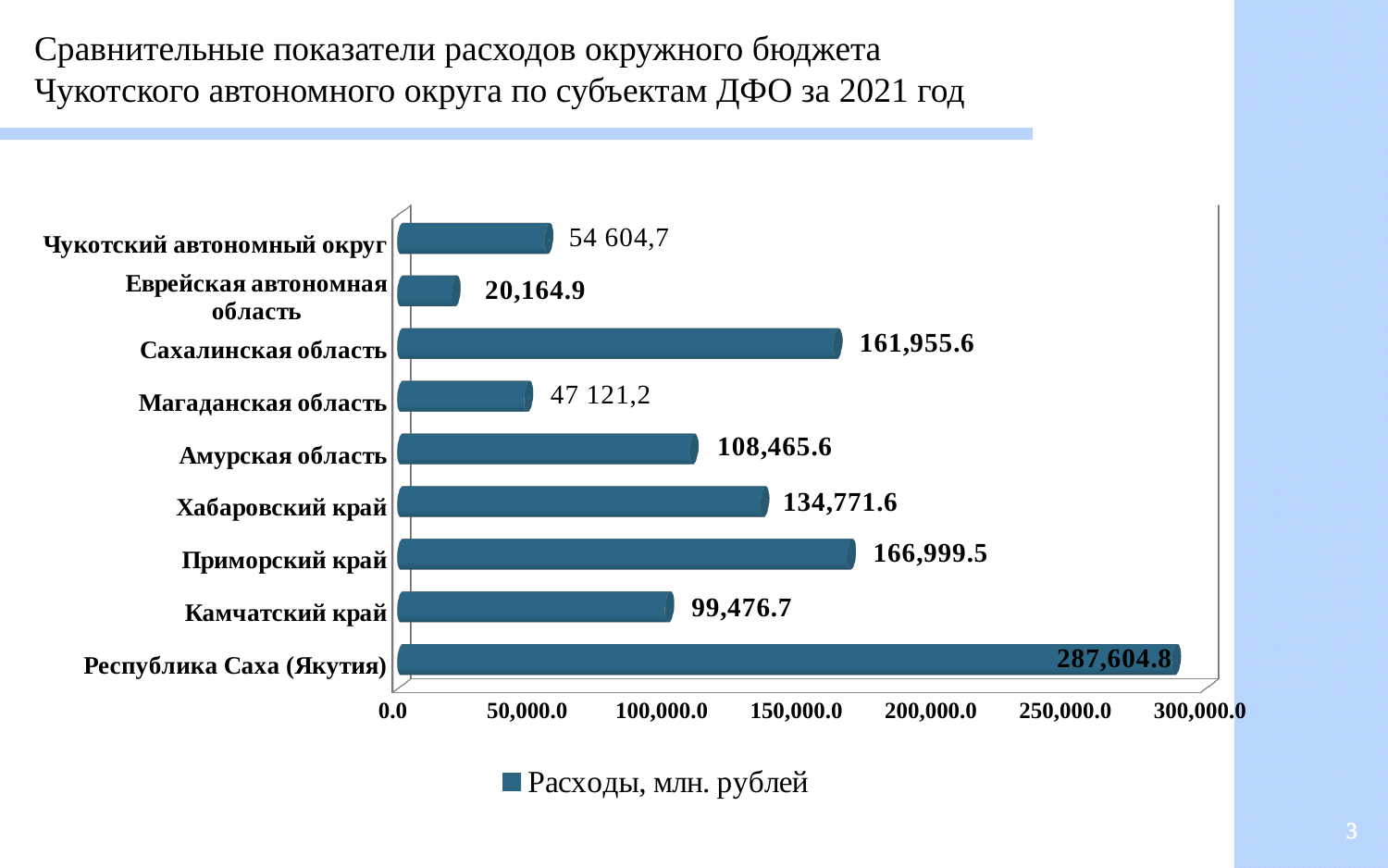
What kind of chart is shown on the slide? bar chart What is the difference between the values for Хабаровский край and Амурская область? 26,306.0 How many regions are shown in the chart? 9 What is the value for Чукотский автономный округ? 54 604,7 What is the value for Магаданская область? 47 121,2 What is the value for Республика Саха (Якутия)? 287,604.8 Is the value for Республика Саха (Якутия) greater or less than 250,000.0? greater What is the value for Хабаровский край? 134,771.6 How many series does the legend list? 1 Which region has the highest value? Республика Саха (Якутия) Which is larger, the value for Приморский край or the value for Сахалинская область? Приморский край Which region has the lowest value? Еврейская автономная область